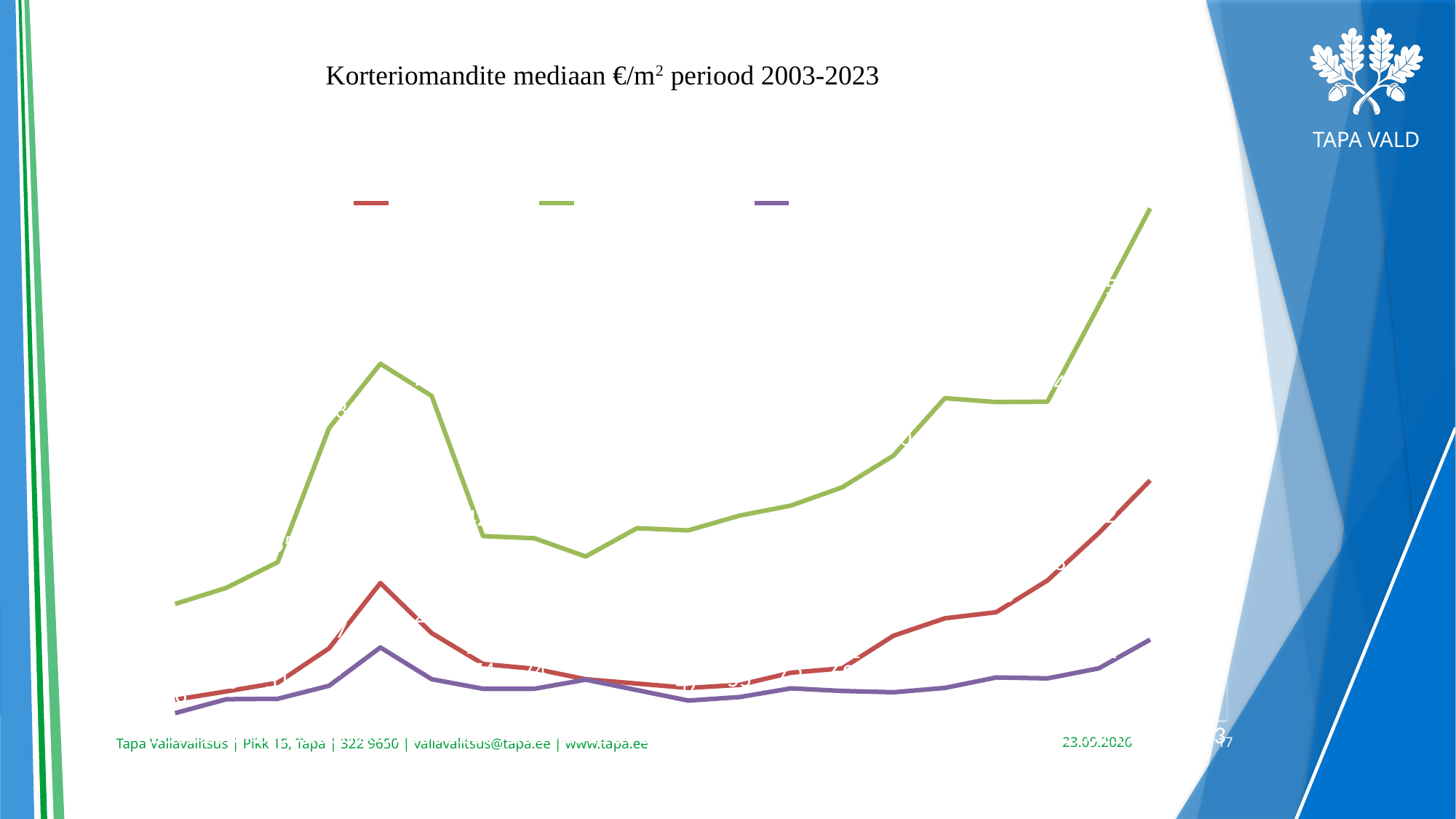
Does the red line rise or fall over the last few points on the right of the chart? rise Which coloured line has the lowest values at the right end of the chart? the purple line How many series does the legend list? 3 What colours are the three lines in the chart? red, green and purple At the last point on the right, which is larger, the green line or the red line? the green line What is the title of the chart? Korteriomandite mediaan €/m² periood 2003-2023 What kind of chart is shown on the slide? line chart Which coloured line has the highest values across the chart? the green line Does the green line end higher or lower than it starts? higher